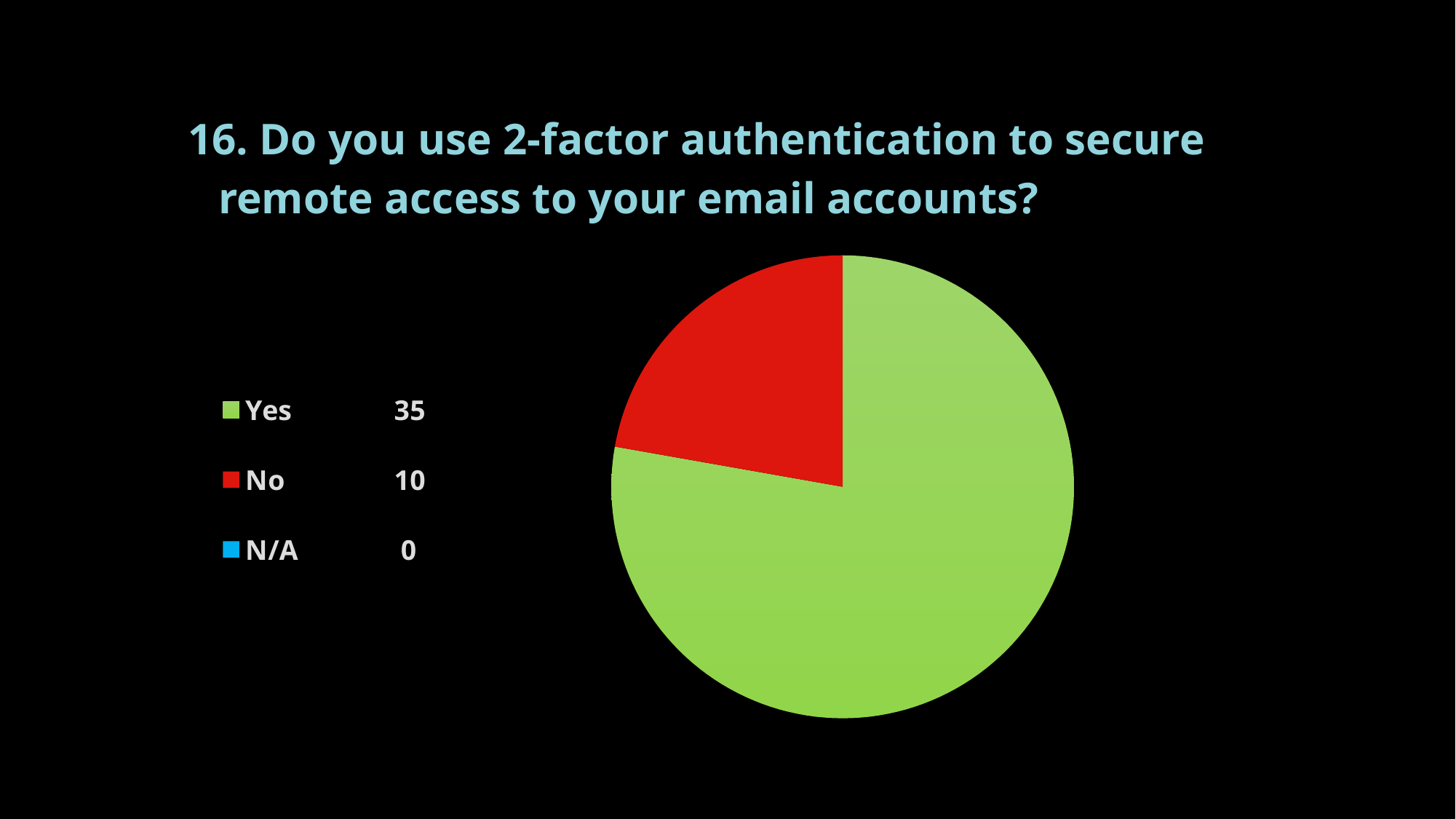
What kind of chart is shown on the slide? pie chart How many categories does the legend list? 3 What is the value for No? 10 What colour is the slice for No? red Which category has the lowest value? N/A What is the value for N/A? 0 What colour is the slice for Yes? green Which is larger, the value for Yes or the value for No? Yes What is the difference between the values for Yes and No? 25 Which category has the highest value? Yes What is the value for Yes? 35 What is the total of all the values shown in the legend? 45